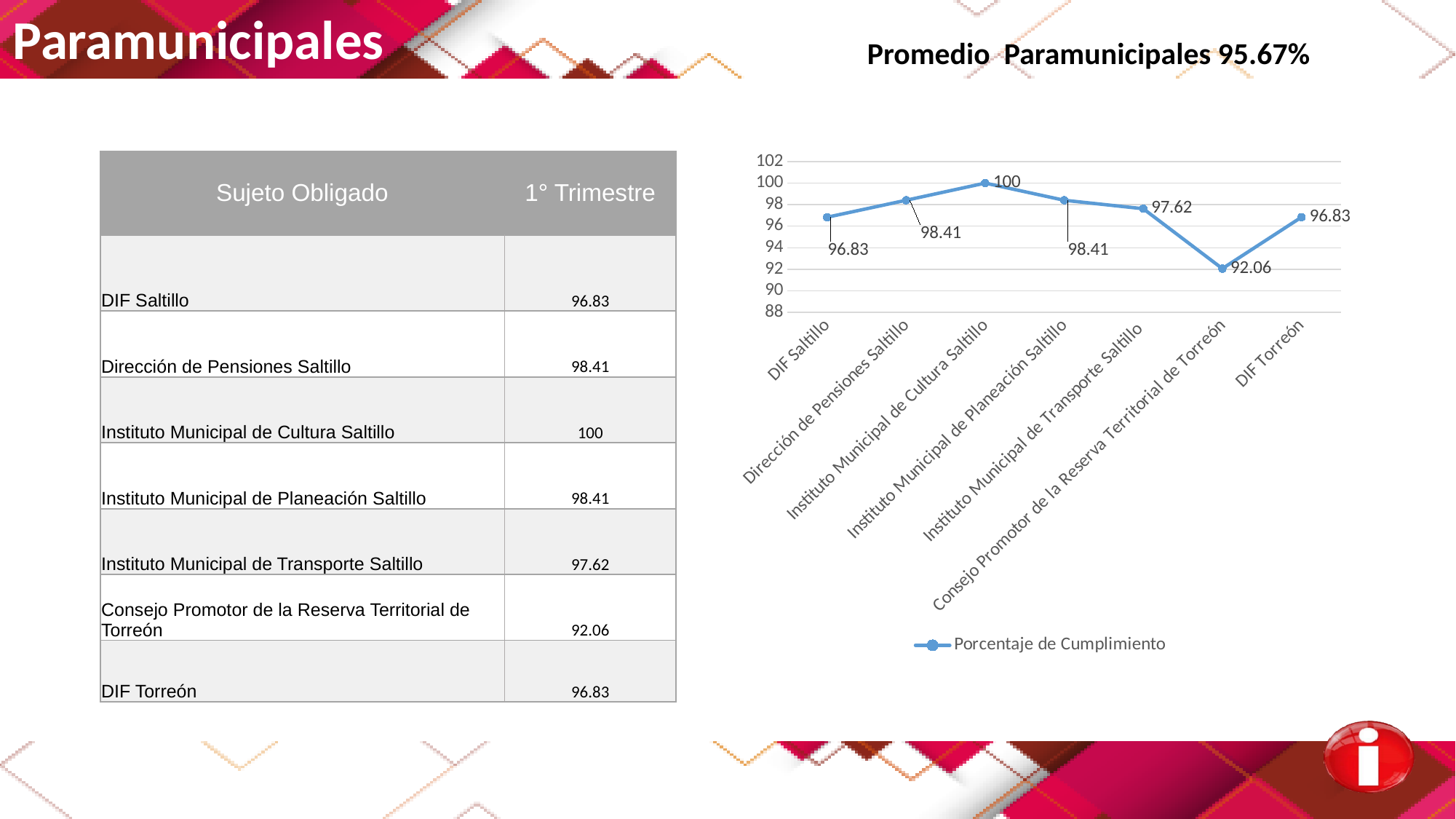
Which is larger, the value for Dirección de Pensiones Saltillo or the value for Instituto Municipal de Transporte Saltillo? Dirección de Pensiones Saltillo What type of chart is shown on the slide? line chart How many series does the chart legend list? 1 Is the value for DIF Torreón greater or less than 94? greater What is the value for Instituto Municipal de Cultura Saltillo in the chart? 100 What is the value for Instituto Municipal de Transporte Saltillo in the chart? 97.62 Which category has the lowest value in the chart? Consejo Promotor de la Reserva Territorial de Torreón How many categories are plotted on the x axis of the chart? 7 Which category has the highest value in the chart? Instituto Municipal de Cultura Saltillo What is the difference between the values for Instituto Municipal de Cultura Saltillo and Consejo Promotor de la Reserva Territorial de Torreón? 7.94 What is the name of the series shown in the chart legend? Porcentaje de Cumplimiento What is the value for Consejo Promotor de la Reserva Territorial de Torreón in the chart? 92.06